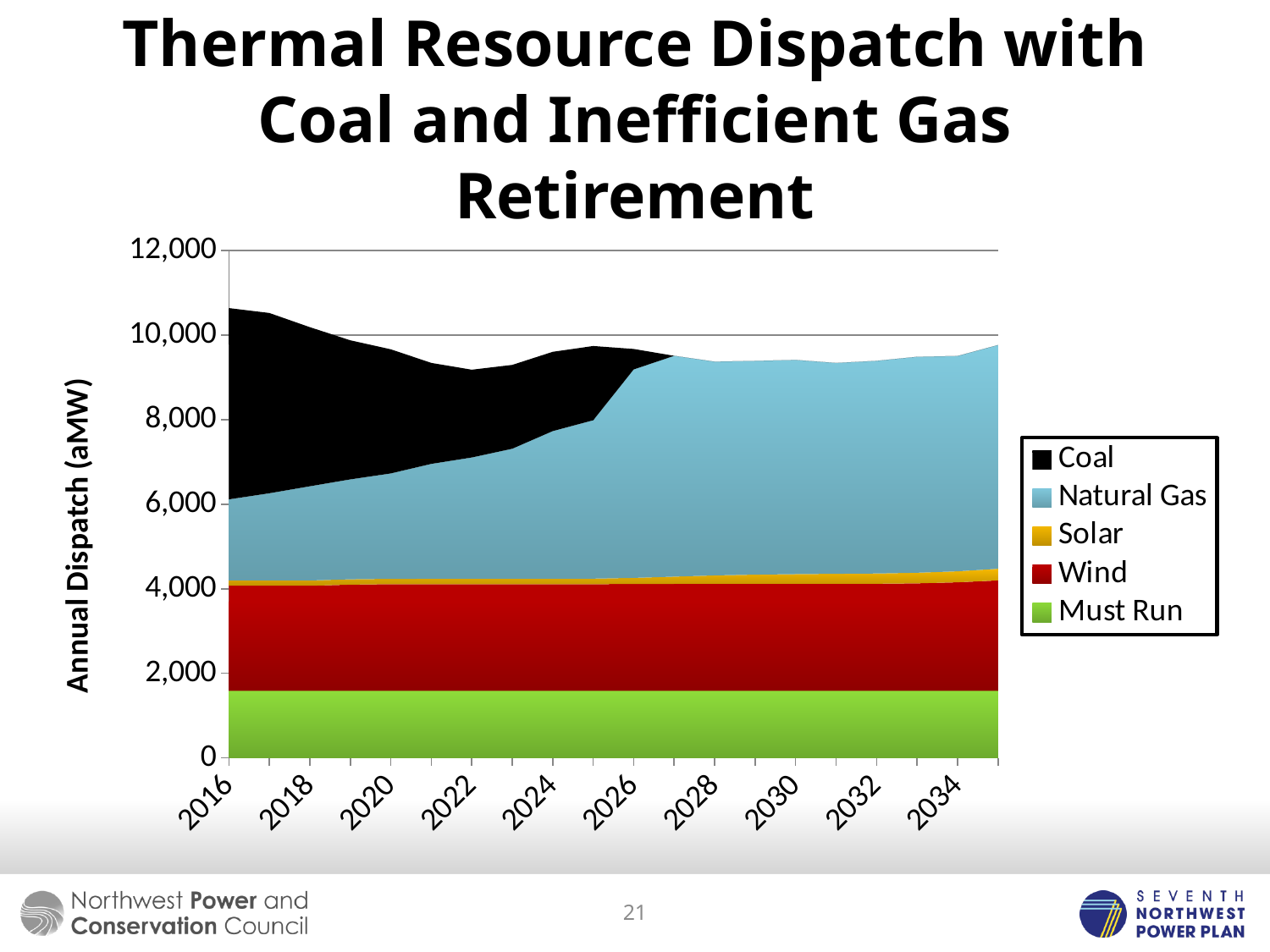
What is the title of the chart? Thermal Resource Dispatch with Coal and Inefficient Gas Retirement Is the Must Run value in 2020 greater or less than 2,000? less Does the Natural Gas area rise or fall from 2016 to 2035? rise Which is larger, the total annual dispatch in 2016 or in 2030? 2016 Is the total annual dispatch in 2030 greater or less than 10,000? less Which series is at the bottom of the stack? Must Run What kind of chart is shown on the slide? Stacked area chart Is the total annual dispatch in 2016 greater or less than 10,000? greater Does the Coal area rise or fall from 2016 to 2035? fall How many series does the legend list? 5 How many year labels are shown on the x axis? 10 What is the label on the vertical axis? Annual Dispatch (aMW)